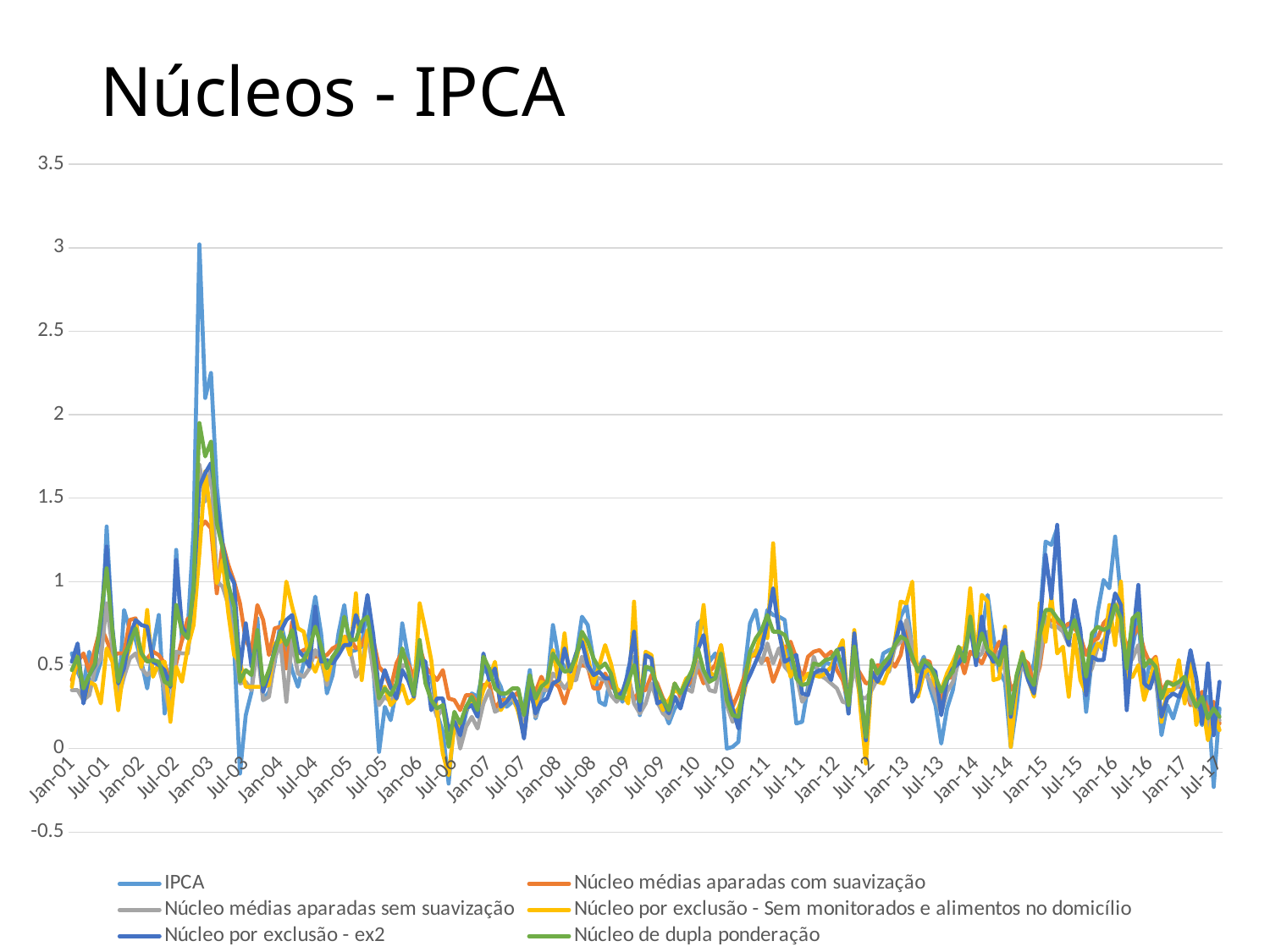
What is the first x-axis label on the chart? Jan-01 Do the series values rise or fall between Jan-03 and Jan-06? fall What is the title of the chart? Núcleos - IPCA Are the values of the IPCA series around Jan-08 greater or less than 1? less Is the highest peak of the IPCA series greater or less than 2.5? greater What is the last x-axis label on the chart? Jul-17 What kind of chart is shown on the slide? line chart What is the lowest value shown on the vertical axis? -0.5 Near which x-axis label does the IPCA series reach its highest peak? Jan-03 What is the highest value shown on the vertical axis? 3.5 Which series reaches the highest peak on the chart? IPCA How many series does the legend list? 6